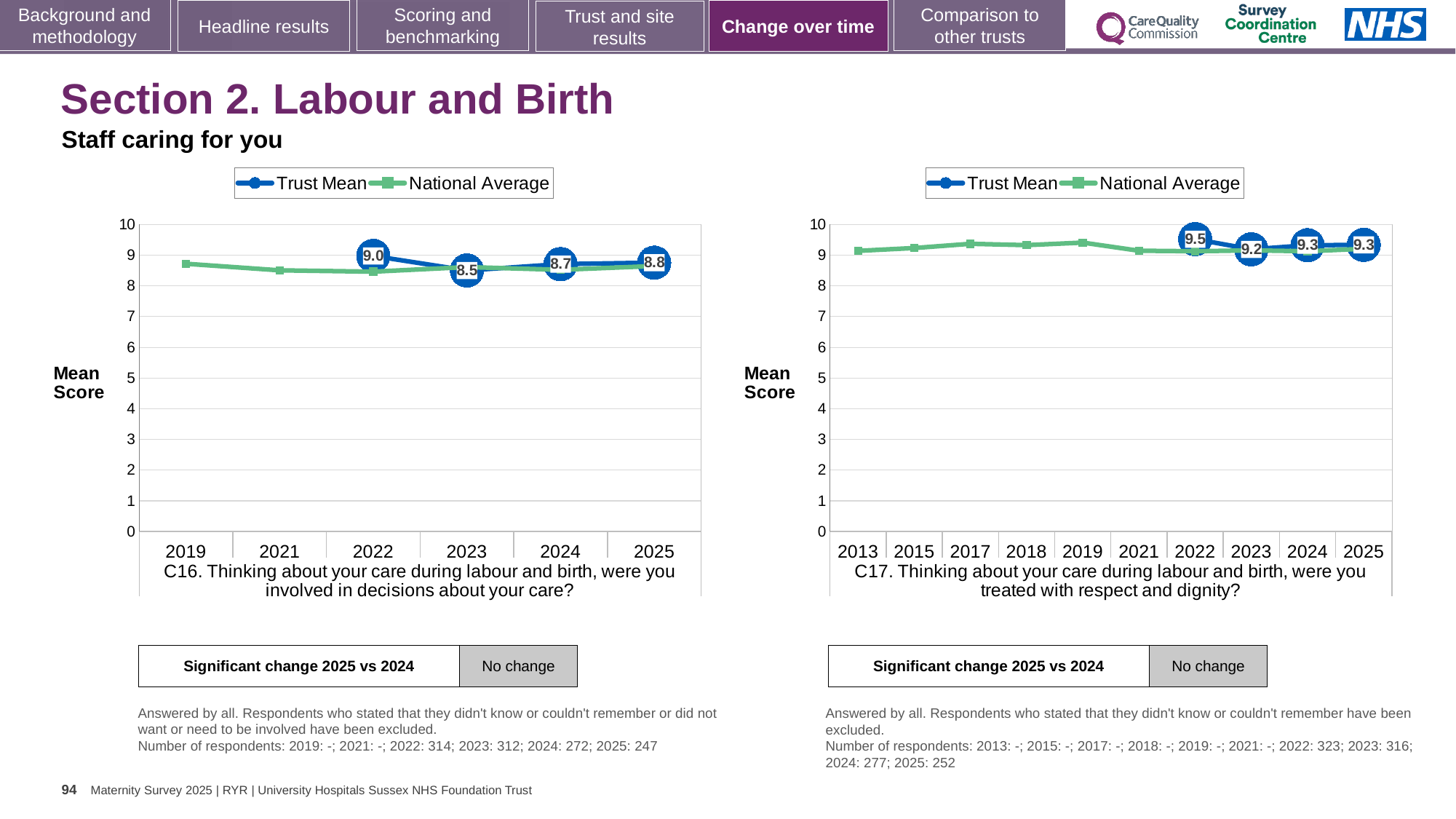
In the C16 chart on the left, what is the Trust Mean value for 2025? 8.8 In the C17 chart on the right, what is the Trust Mean value for 2023? 9.2 In the C16 chart on the left, is the National Average value for 2019 greater or less than 8? greater In the C17 chart on the right, is the Trust Mean value for 2022 larger or smaller than the value for 2023? larger What type of chart is the C16 chart on the left? Line chart How many years are shown on the x axis of the C17 chart on the right? 10 In the C16 chart on the left, what is the Trust Mean value for 2022? 9.0 In the C16 chart on the left, which year has the lowest labelled Trust Mean value? 2023 In the C16 chart on the left, what is the difference between the Trust Mean values for 2022 and 2023? 0.5 How many series does the legend of the C16 chart on the left list? 2 In the C17 chart on the right, which year has the highest labelled Trust Mean value? 2022 In the C17 chart on the right, what is the Trust Mean value for 2022? 9.5